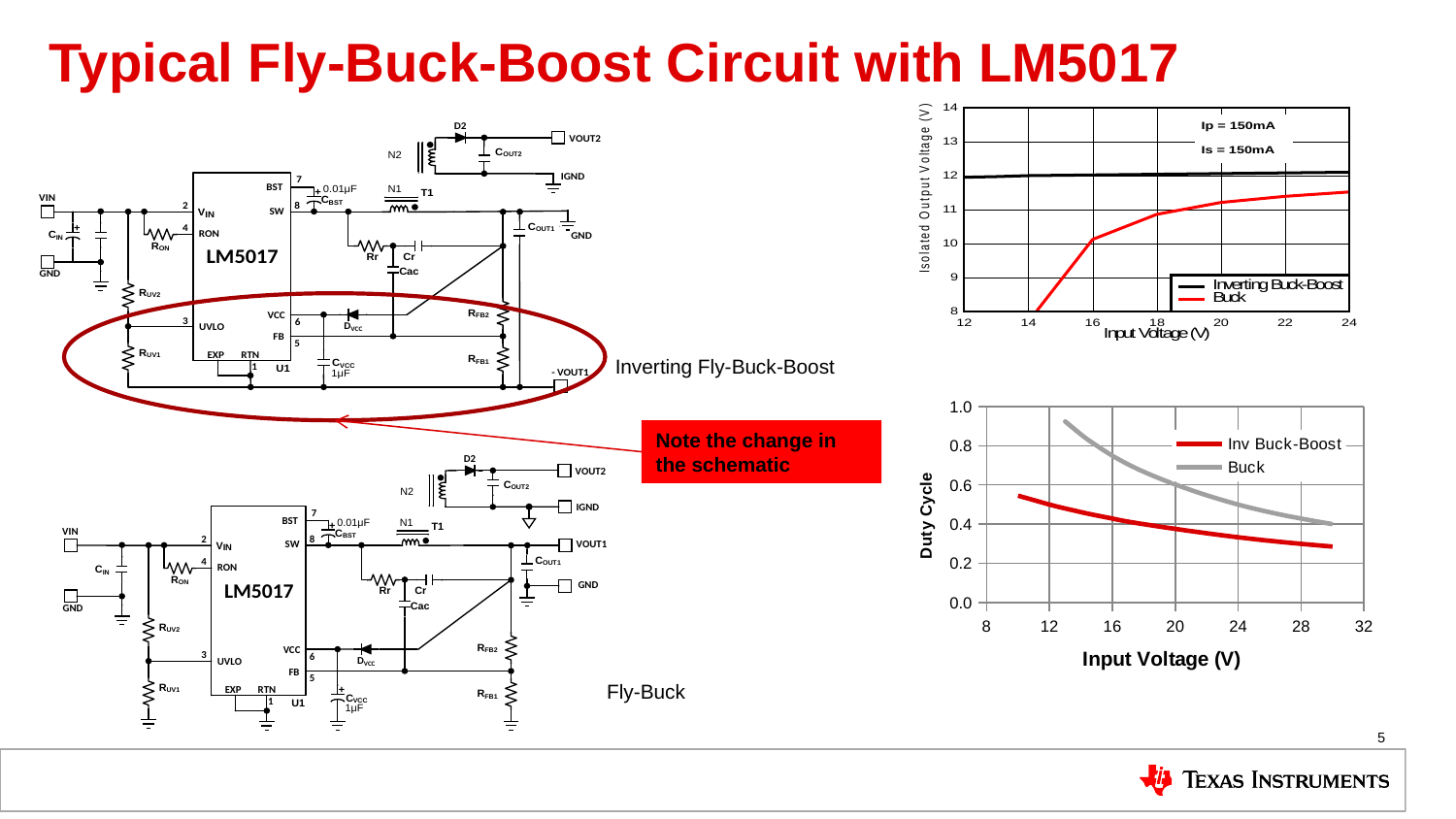
How many series does the legend of the bottom-right Duty Cycle chart list? 2 In the top-right Isolated Output Voltage chart, is the Buck value at 20 V input greater or less than 10? greater In the bottom-right Duty Cycle chart, at 20 V input, which series has the higher duty cycle, Inv Buck-Boost or Buck? Buck What type of chart is the top-right chart showing Isolated Output Voltage versus Input Voltage? line chart What peak current values are annotated on the top-right Isolated Output Voltage chart? Ip = 150mA, Is = 150mA In the top-right Isolated Output Voltage chart, does the Buck series rise or fall as input voltage increases? rise In the bottom-right Duty Cycle chart, does the Inv Buck-Boost duty cycle rise or fall as input voltage increases? fall In the top-right Isolated Output Voltage chart, is the Inverting Buck-Boost value at 12 V input greater or less than 13? less How many series does the legend of the top-right Isolated Output Voltage chart list? 2 In the bottom-right Duty Cycle chart, is the Buck duty cycle at 16 V input greater or less than 0.6? greater What type of chart is the bottom-right Duty Cycle chart? line chart In the top-right Isolated Output Voltage chart, at 16 V input, which series has the higher isolated output voltage, Inverting Buck-Boost or Buck? Inverting Buck-Boost